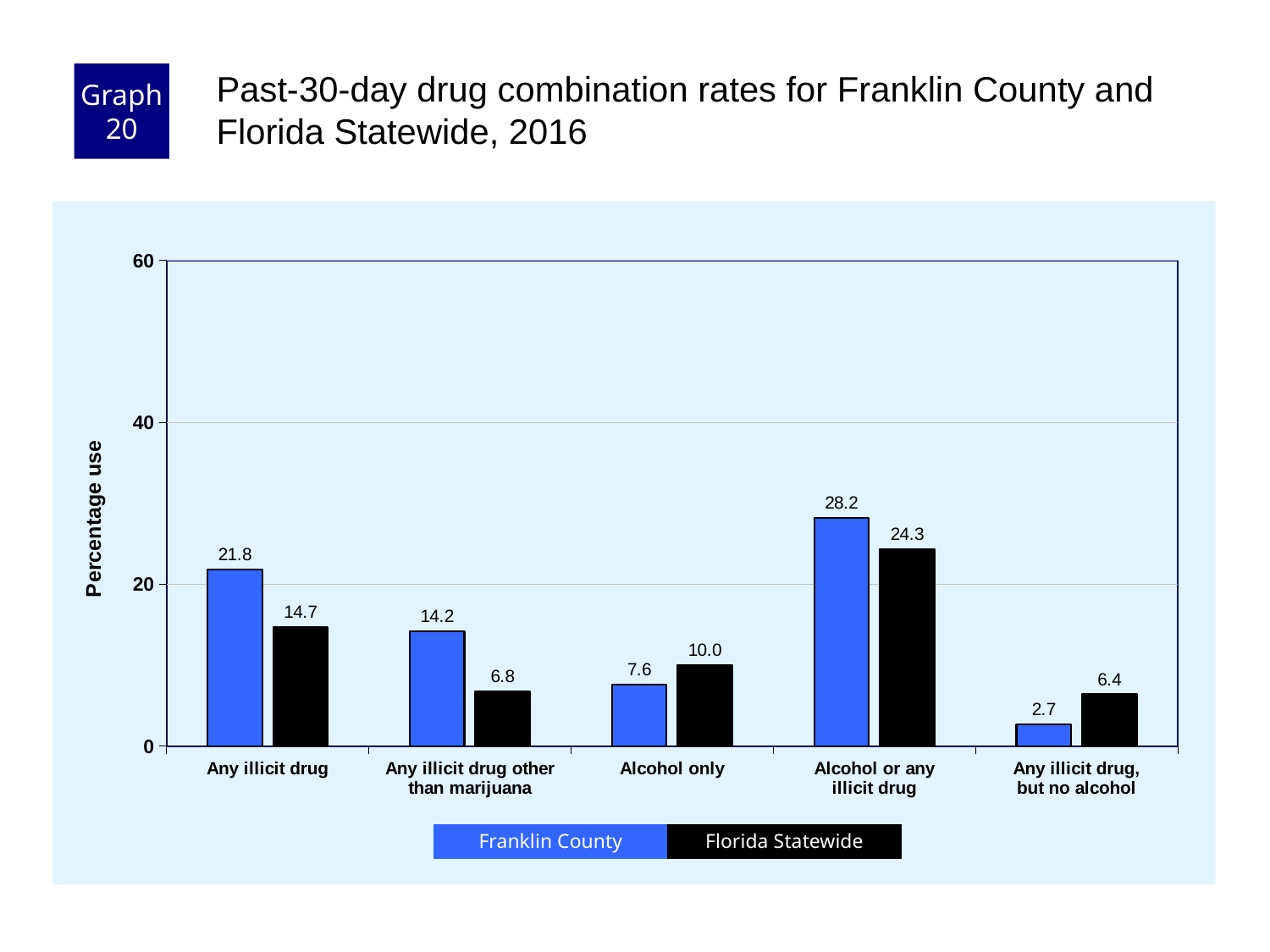
How many series does the legend list? 2 What is the Florida Statewide value for Alcohol only? 10.0 What is the difference between the Franklin County and Florida Statewide values for Any illicit drug other than marijuana? 7.4 What is the Franklin County value for Any illicit drug, but no alcohol? 2.7 Which category has the lowest Florida Statewide value? Any illicit drug, but no alcohol What kind of chart is shown on the slide? bar chart Which category has the highest Franklin County value? Alcohol or any illicit drug What is the Franklin County value for Any illicit drug? 21.8 Which is larger for Alcohol only: Franklin County or Florida Statewide? Florida Statewide How many categories are shown on the x axis? 5 Is the Florida Statewide value for Alcohol or any illicit drug greater or less than 20? greater What is the label of the y axis? Percentage use